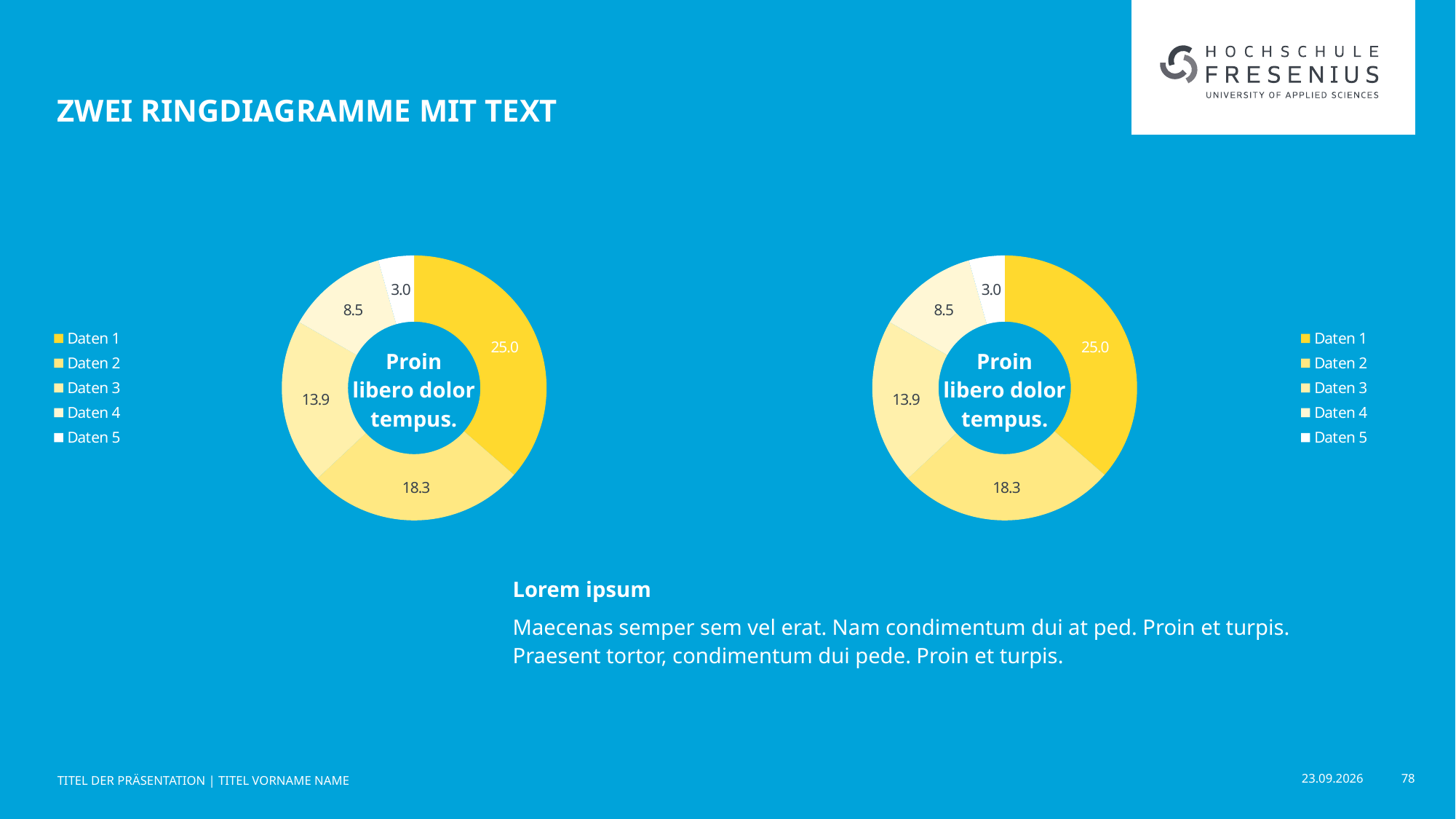
In the left doughnut chart, which category has the highest value? Daten 1 In the left doughnut chart, which is larger, the value for Daten 2 or the value for Daten 3? Daten 2 What type of chart is shown on the left of the slide? Doughnut chart In the right doughnut chart, what is the value for Daten 3? 13.9 What text is printed in the centre of the left doughnut chart? Proin libero dolor tempus. In the left doughnut chart, what is the value for Daten 1? 25.0 In the left doughnut chart, what is the difference between the values for Daten 1 and Daten 2? 6.7 How many categories does the legend of the right doughnut chart list? 5 In the left doughnut chart, what is the value for Daten 5? 3.0 In the right doughnut chart, which category has the lowest value? Daten 5 In the right doughnut chart, what is the difference between the values for Daten 3 and Daten 4? 5.4 In the right doughnut chart, what is the value for Daten 4? 8.5